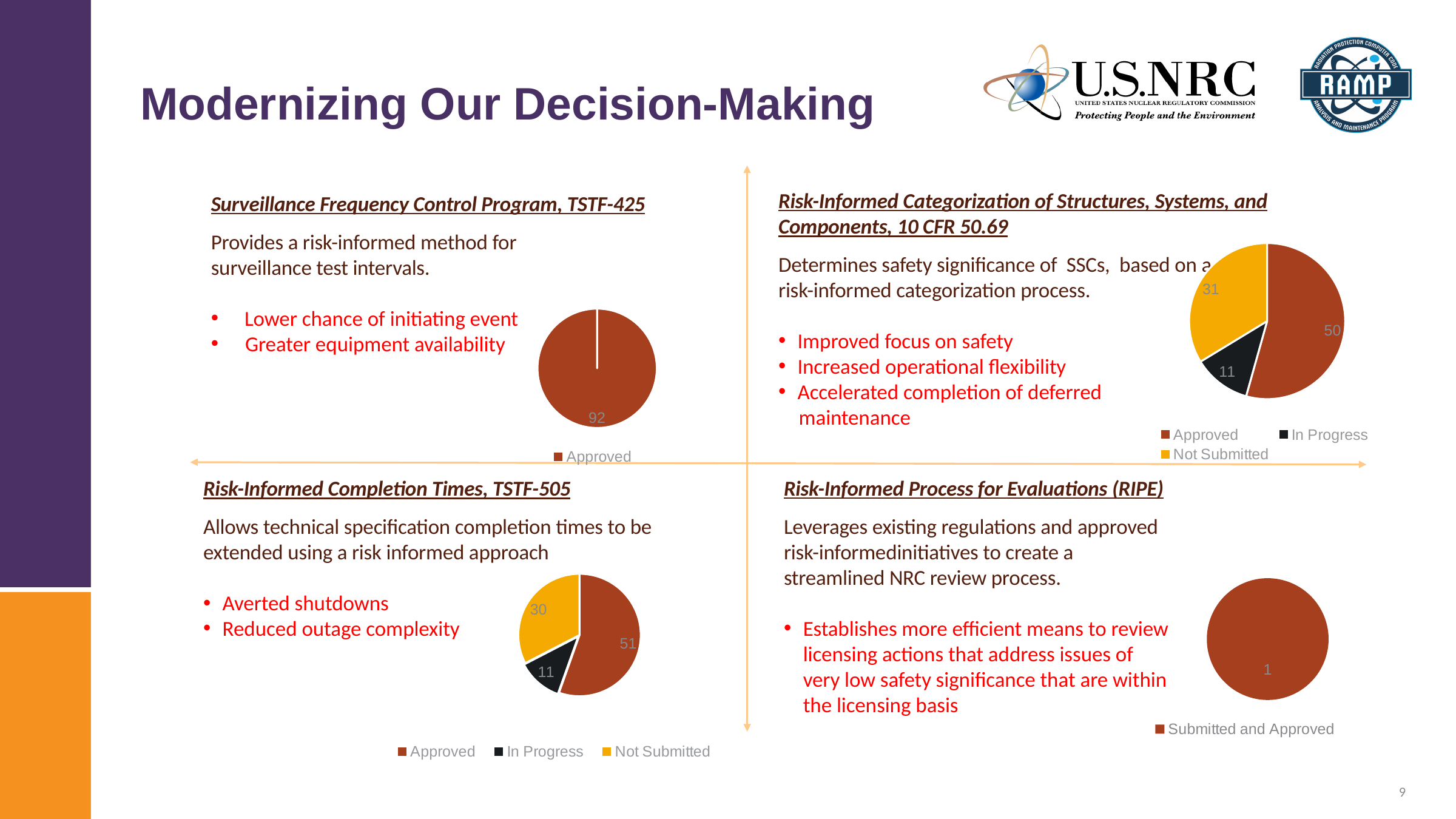
In the pie chart in the top-left quadrant (Surveillance Frequency Control Program, TSTF-425), what is the value for Approved? 92 How many categories does the legend list for the pie chart in the bottom-left quadrant (Risk-Informed Completion Times, TSTF-505)? 3 In the pie chart in the top-right quadrant (Risk-Informed Categorization, 10 CFR 50.69), what is the value for Not Submitted? 31 In the pie chart in the bottom-left quadrant (Risk-Informed Completion Times, TSTF-505), what is the value for In Progress? 11 In the pie chart in the bottom-right quadrant (Risk-Informed Process for Evaluations), what is the value for Submitted and Approved? 1 In the pie chart in the bottom-left quadrant (Risk-Informed Completion Times, TSTF-505), what is the total of all slices? 92 In the pie chart in the bottom-left quadrant (Risk-Informed Completion Times, TSTF-505), which category has the largest slice? Approved In the pie chart in the top-right quadrant (Risk-Informed Categorization, 10 CFR 50.69), what is the difference between Approved and Not Submitted? 19 In the pie chart in the top-right quadrant (Risk-Informed Categorization, 10 CFR 50.69), what is the value for Approved? 50 In the pie chart in the bottom-left quadrant (Risk-Informed Completion Times, TSTF-505), which is larger, Approved or Not Submitted? Approved In the pie chart in the top-right quadrant (Risk-Informed Categorization, 10 CFR 50.69), which category has the smallest slice? In Progress What type of chart is used in the top-right quadrant (Risk-Informed Categorization, 10 CFR 50.69)? Pie chart